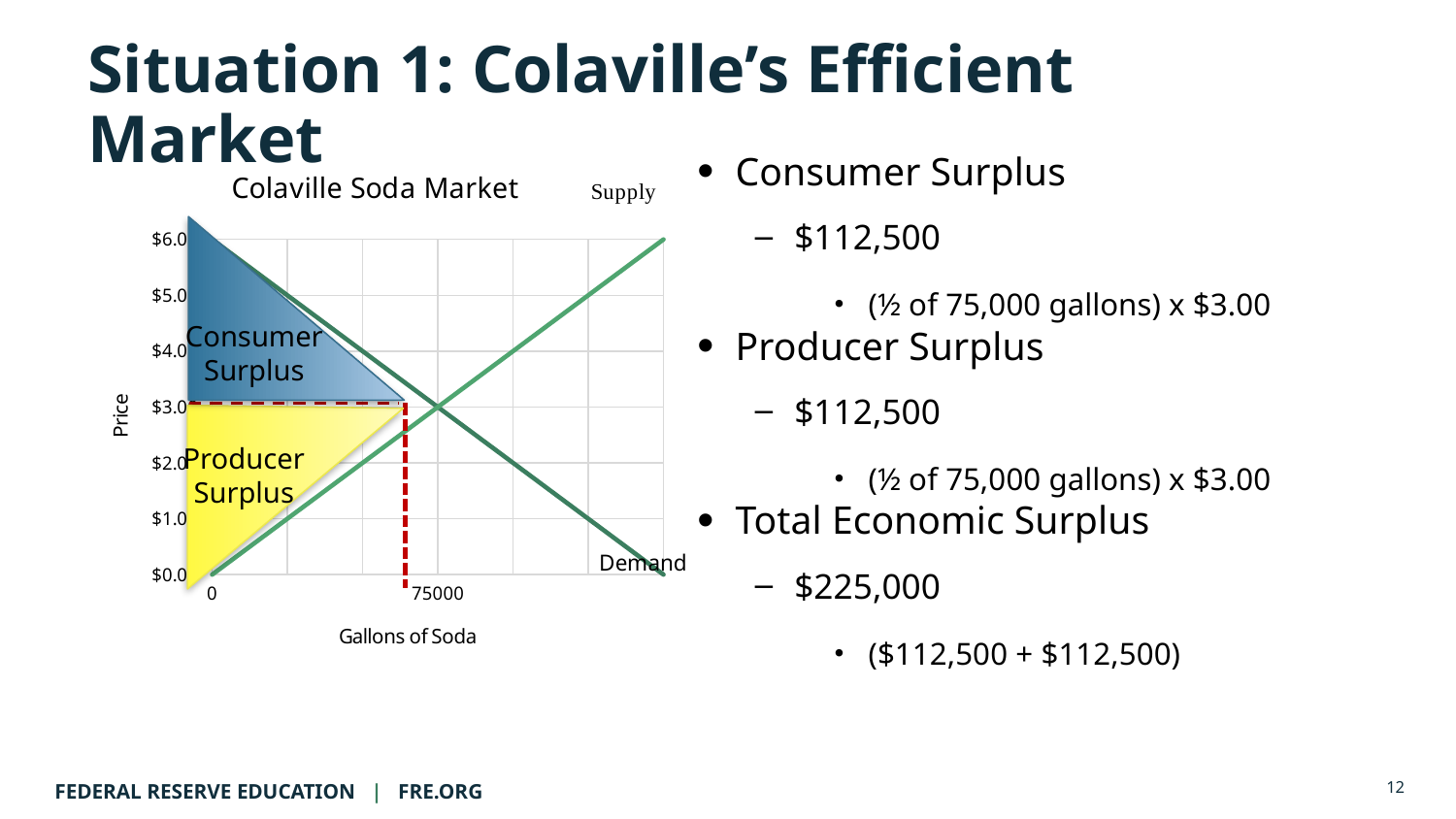
At what price do the Supply and Demand lines intersect, as marked by the dashed line on the y axis? $3.0 What is the title of the chart on the slide? Colaville Soda Market At what quantity of gallons do the Supply and Demand lines intersect, as marked by the dashed line on the x axis? 75000 What kind of chart is shown on the slide? Line chart How many lines (Supply and Demand) are plotted on the chart? 2 Which shaded area lies above the $3.0 price line: Consumer Surplus or Producer Surplus? Consumer Surplus Does the Demand line rise or fall as gallons of soda increase? Fall What is the label of the horizontal axis of the chart? Gallons of Soda What is the highest price tick shown on the vertical axis of the chart? $6.0 What is the label of the vertical axis of the chart? Price Does the Supply line rise or fall as gallons of soda increase? Rise Is the price at which Supply and Demand intersect greater or less than $4.0? less